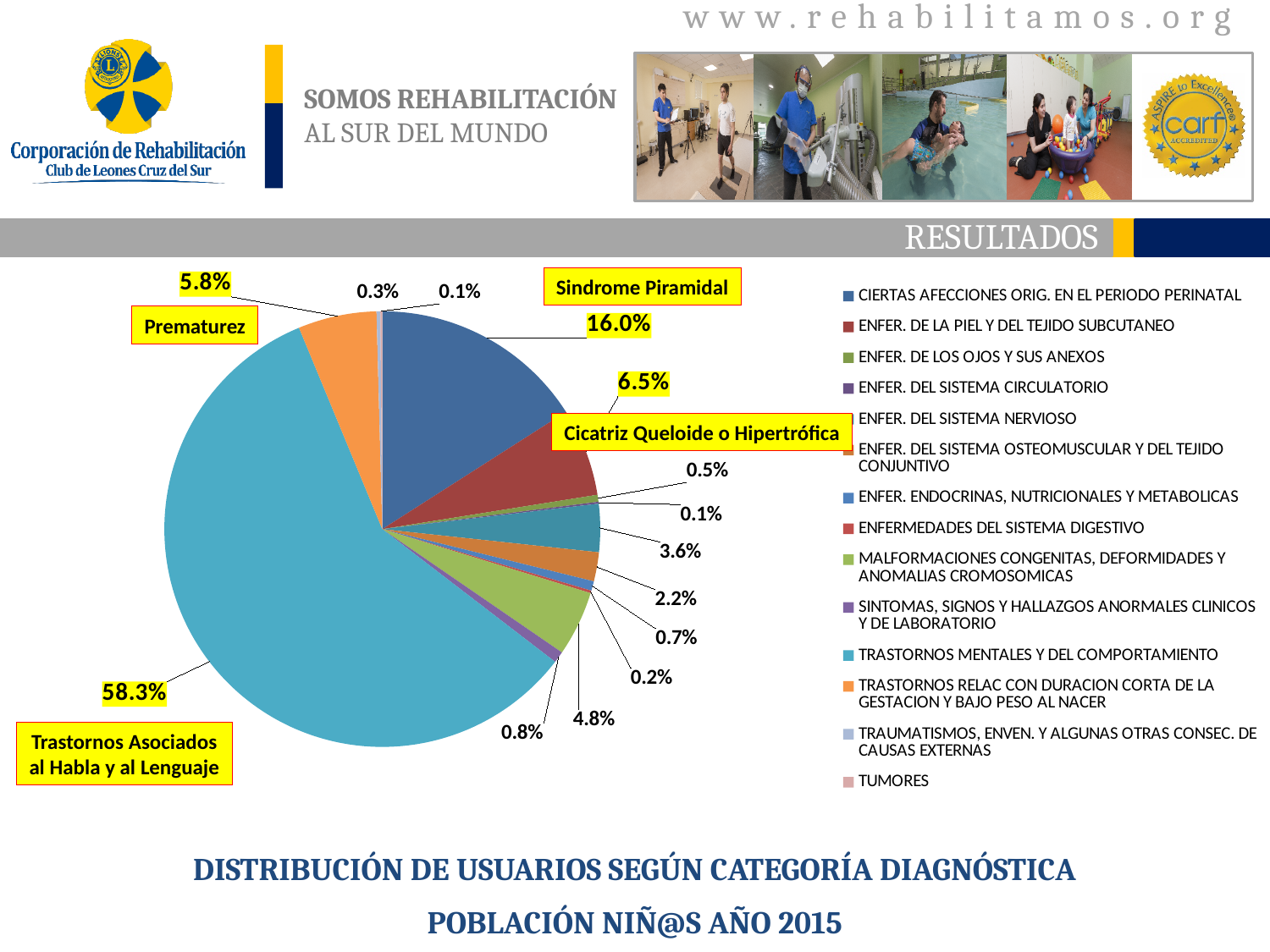
What is the smallest percentage value labelled on the pie chart? 0.1% What percentage is shown for the slice annotated 'Sindrome Piramidal'? 16.0% What share of the pie is labelled for the slice annotated 'Trastornos Asociados al Habla y al Lenguaje'? 58.3% What percentage is shown for the slice annotated 'Cicatriz Queloide o Hipertrófica'? 6.5% What percentage is shown for the slice annotated 'Prematurez'? 5.8% How many entries does the legend list? 14 Which is larger, the 'Prematurez' slice or the 'Cicatriz Queloide o Hipertrófica' slice? Cicatriz Queloide o Hipertrófica What is the title of the chart shown on the slide? DISTRIBUCIÓN DE USUARIOS SEGÚN CATEGORÍA DIAGNÓSTICA POBLACIÓN NIÑ@S AÑO 2015 What is the difference between the 'Sindrome Piramidal' slice and the 'Cicatriz Queloide o Hipertrófica' slice? 9.5% What is the difference between the 'Trastornos Asociados al Habla y al Lenguaje' slice and the 'Sindrome Piramidal' slice? 42.3% What kind of chart is shown on the slide? pie chart Which annotated slice has the largest share of the pie? Trastornos Asociados al Habla y al Lenguaje